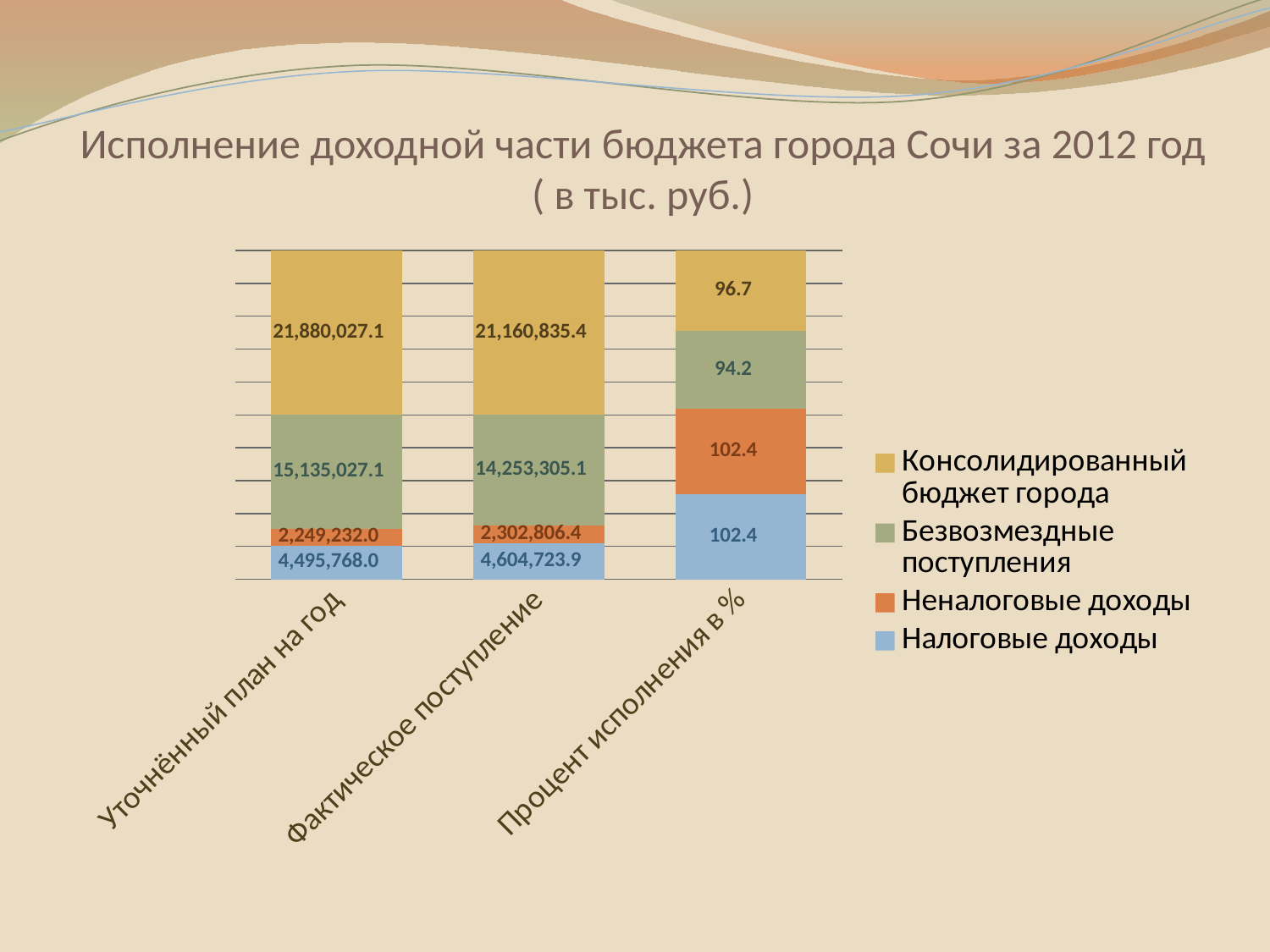
What is the value of Безвозмездные поступления for Процент исполнения в %? 94.2 What is the value of Налоговые доходы for Фактическое поступление? 4,604,723.9 What is the value of Консолидированный бюджет города for Уточнённый план на год? 21,880,027.1 What type of chart is shown on the slide? Stacked bar chart Which series is shown in orange in the legend? Неналоговые доходы What is the value of Неналоговые доходы for Уточнённый план на год? 2,249,232.0 What is the difference between Налоговые доходы for Фактическое поступление and for Уточнённый план на год? 108,955.9 Which is larger: Безвозмездные поступления for Уточнённый план на год or for Фактическое поступление? Уточнённый план на год What is the value of Консолидированный бюджет города for Процент исполнения в %? 96.7 How many series does the legend list? 4 How many categories are shown on the x axis? 3 What is the difference between Консолидированный бюджет города for Уточнённый план на год and for Фактическое поступление? 719,191.7